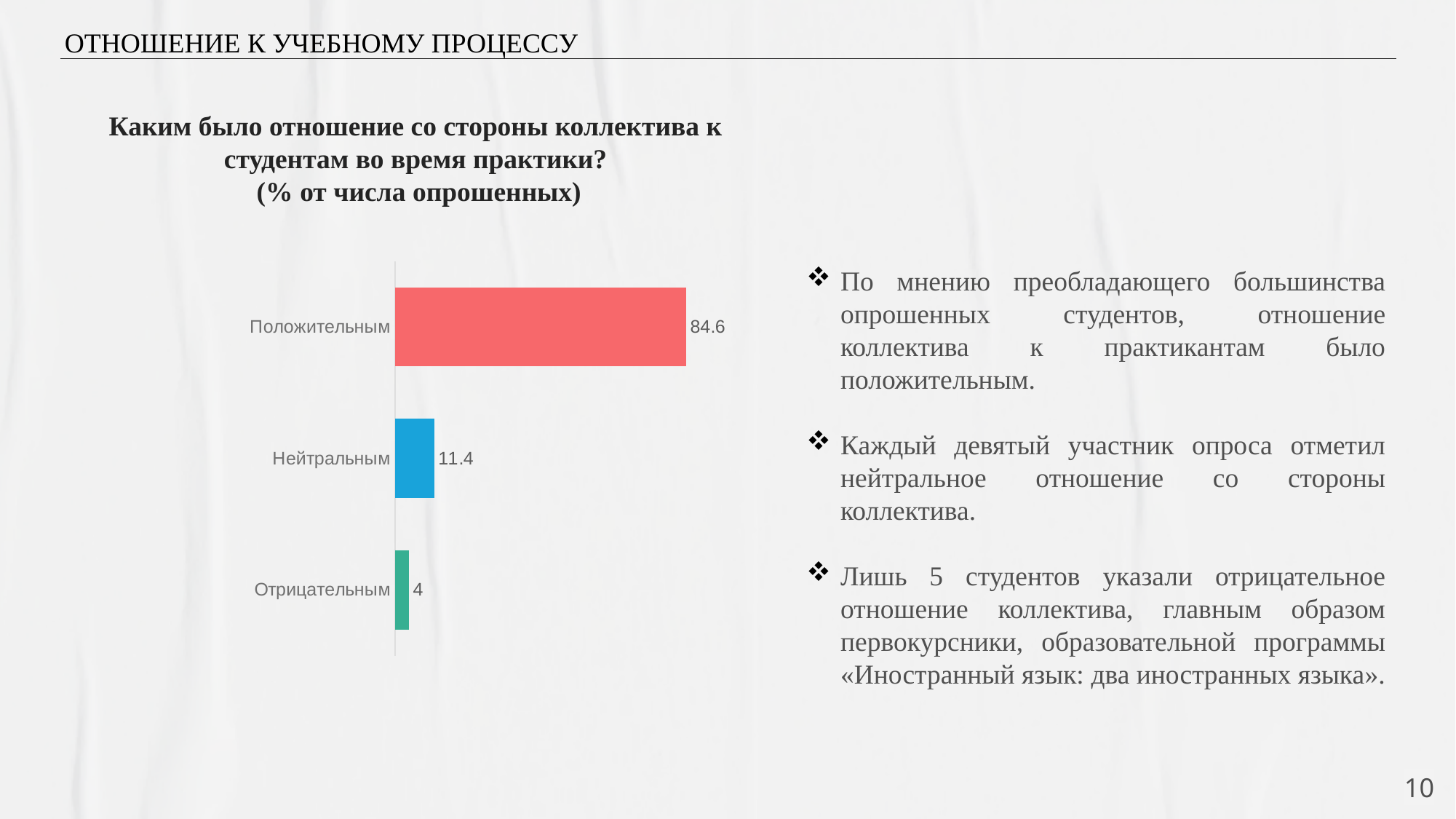
What is the value for Нейтральным? 11.4 What colour is the bar for Нейтральным? blue How many categories are shown in the chart? 3 What is the difference between the values for Нейтральным and Отрицательным? 7.4 What is the value for Отрицательным? 4 What colour is the bar for Положительным? red What is the value for Положительным? 84.6 Which is larger, the value for Нейтральным or the value for Отрицательным? Нейтральным Which category has the lowest value? Отрицательным What kind of chart is shown on the slide? bar chart Which category has the highest value? Положительным What is the difference between the values for Положительным and Нейтральным? 73.2